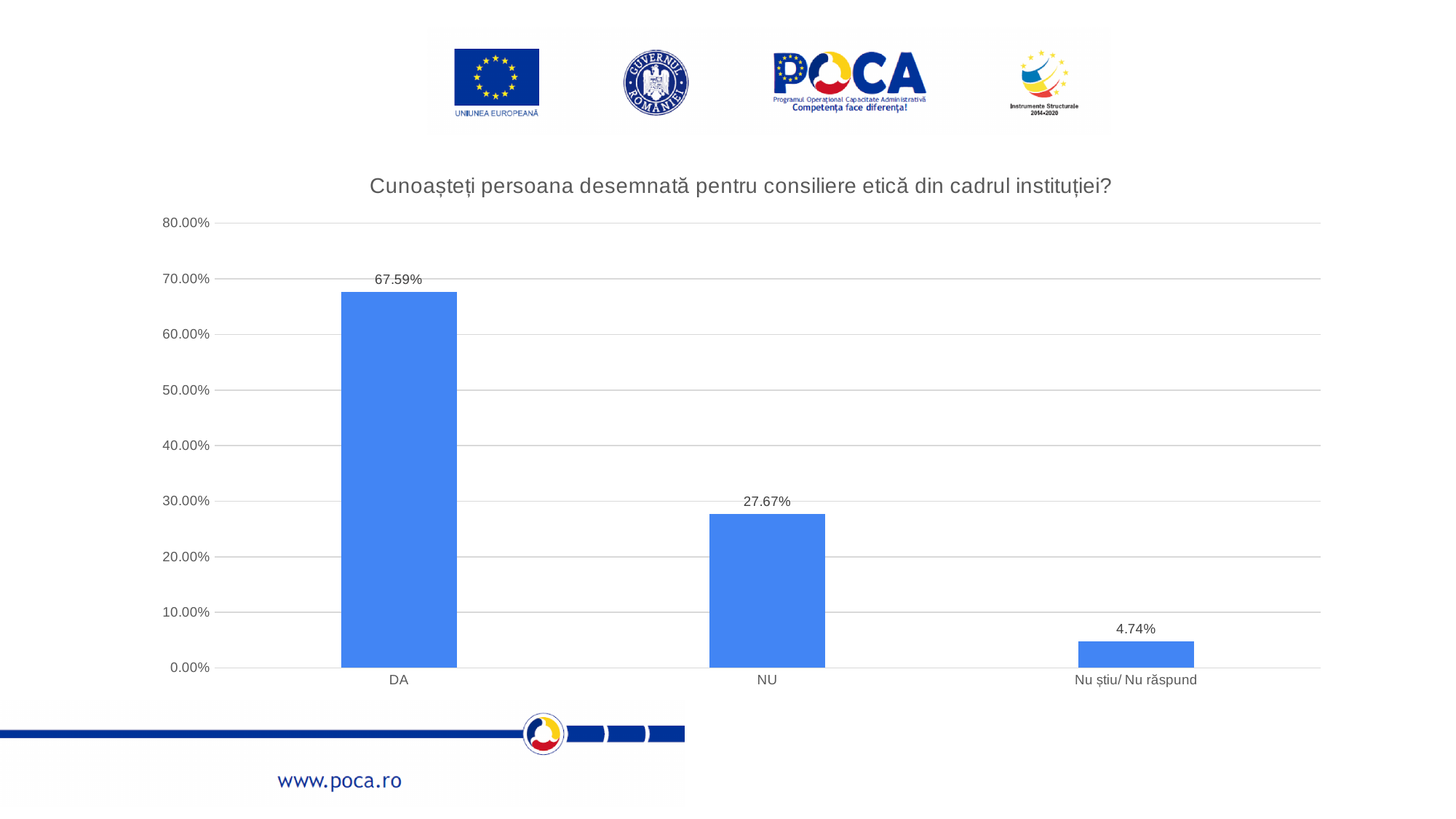
How many categories are shown on the x axis? 3 What is the value for Nu știu/ Nu răspund? 4.74% Is the value for NU greater or less than 30.00%? less Which category has the lowest value? Nu știu/ Nu răspund Which category has the highest value? DA What kind of chart is shown on the slide? bar chart What is the difference between the values for DA and NU? 39.92% What is the difference between the values for NU and Nu știu/ Nu răspund? 22.93% Which is larger, the value for NU or the value for Nu știu/ Nu răspund? NU What is the value for DA? 67.59% What is the title of the chart? Cunoașteți persoana desemnată pentru consiliere etică din cadrul instituției? What is the value for NU? 27.67%